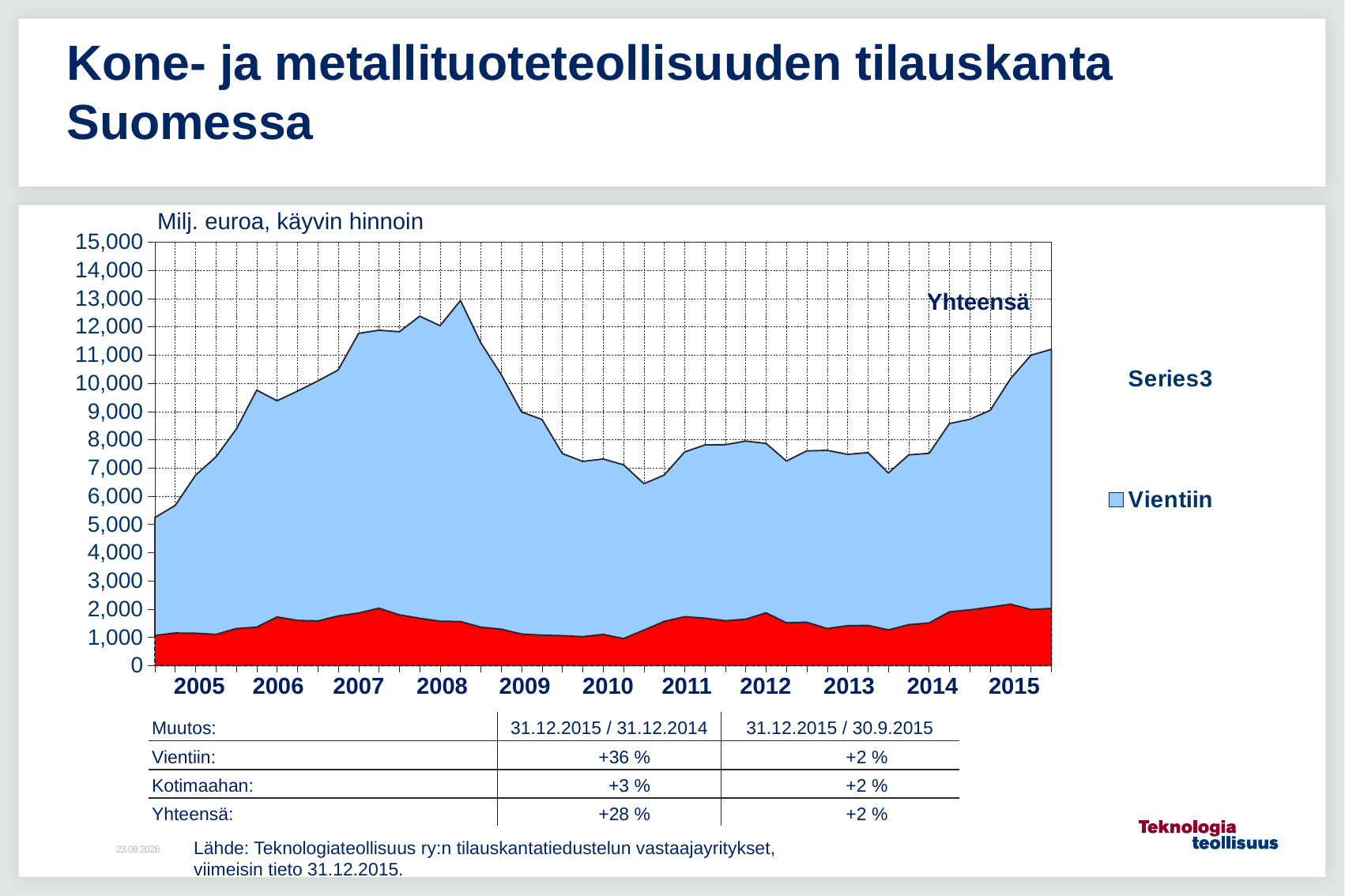
In which year does the total (Yhteensä) reach its highest peak? 2008 Does the total (Yhteensä) rise or fall from its 2008 peak to 2010? fall How many years are labelled on the x axis of the chart? 11 What kind of chart is shown on the slide? area chart How many series does the chart legend list? 2 Which legend entry is shown with the light blue colour? Vientiin Is the peak total value in 2008 greater or less than 12,000? greater In which year is the total (Yhteensä) at its lowest level? 2005 Is the total value at the end of 2015 greater or less than 10,000? greater What unit label is shown above the chart? Milj. euroa, käyvin hinnoin Is the total value at the start of 2005 greater or less than 6,000? less